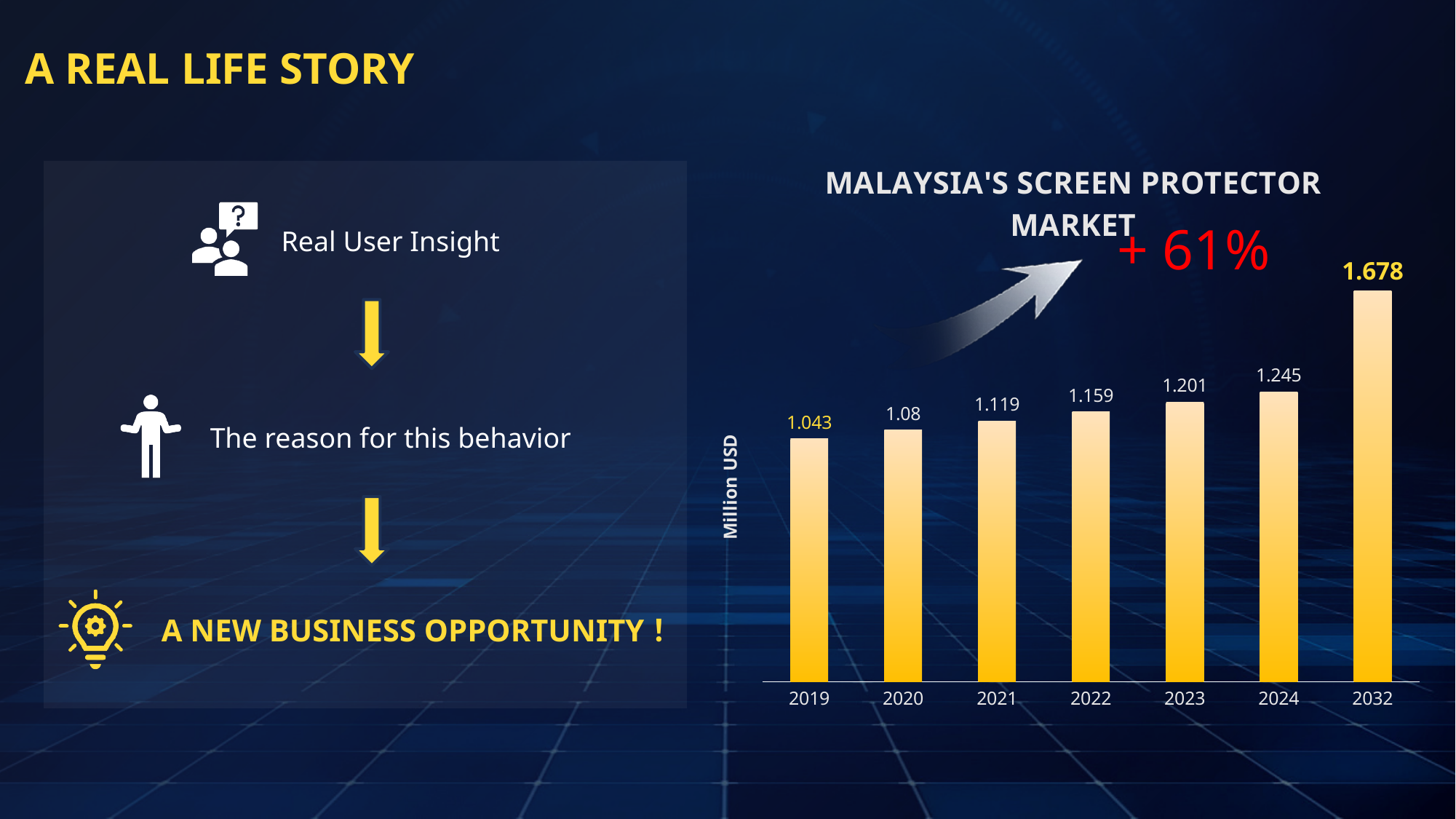
What unit is shown on the y axis label of the Malaysia's Screen Protector Market chart? Million USD What is the value for 2020 in the Malaysia's Screen Protector Market chart? 1.08 What is the value for 2019 in the Malaysia's Screen Protector Market chart? 1.043 What kind of chart is the Malaysia's Screen Protector Market chart? Bar chart Do the values in the Malaysia's Screen Protector Market chart rise or fall from 2019 to 2032? Rise Which year has the highest value in the Malaysia's Screen Protector Market chart? 2032 How many years are shown on the x axis of the Malaysia's Screen Protector Market chart? 7 What is the value for 2023 in the Malaysia's Screen Protector Market chart? 1.201 What is the value for 2032 in the Malaysia's Screen Protector Market chart? 1.678 Which year has the lowest value in the Malaysia's Screen Protector Market chart? 2019 Which is larger in the Malaysia's Screen Protector Market chart, the value for 2021 or the value for 2022? 2022 What is the difference between the values for 2032 and 2024 in the Malaysia's Screen Protector Market chart? 0.433